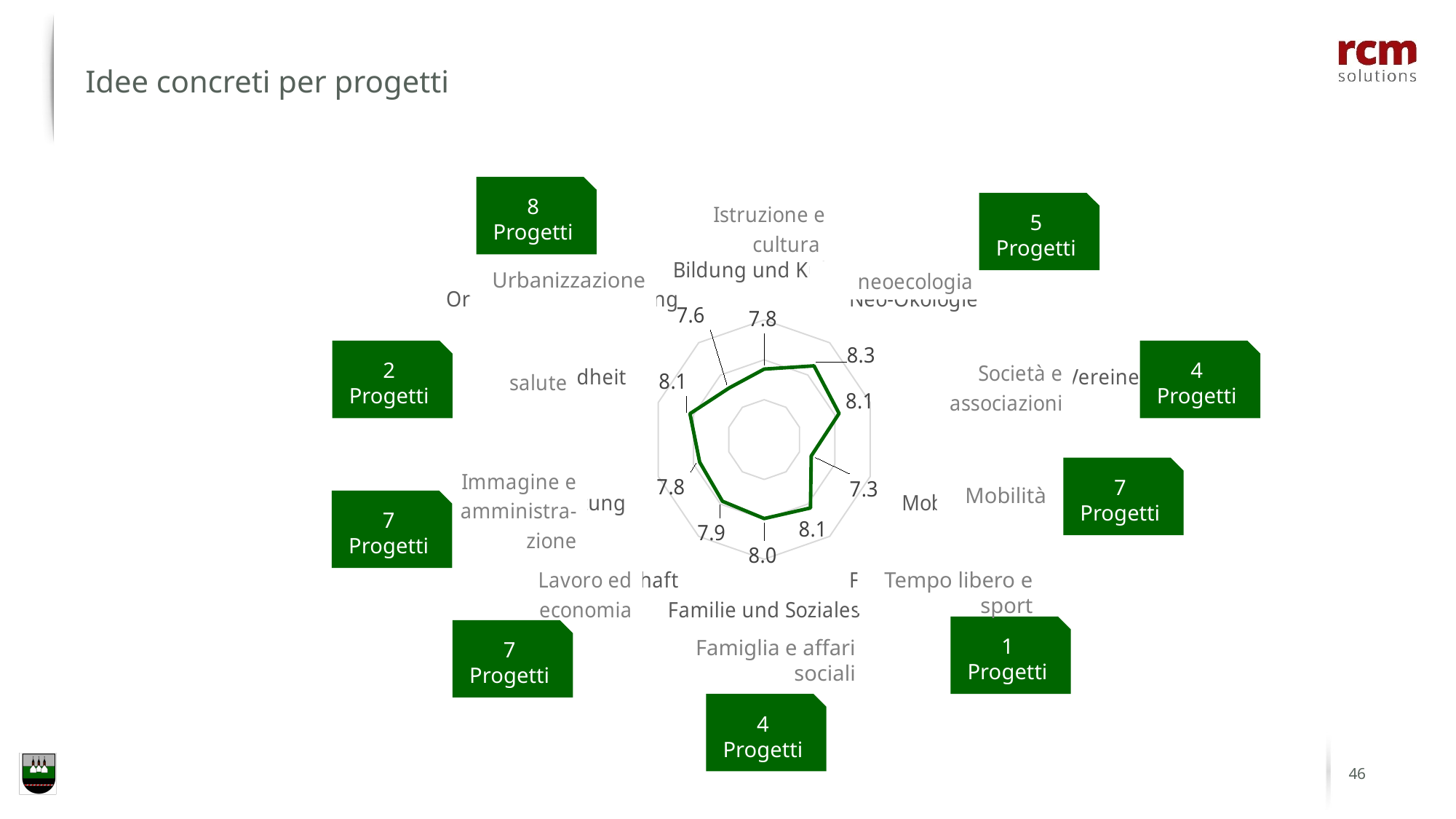
Which has a larger value, Lavoro ed economia or Urbanizzazione? Lavoro ed economia How many categories (axes) does the radar chart have? 10 What is the value for Urbanizzazione on the radar chart? 7.6 Which category has the lowest value on the radar chart? Mobilità What is the value for Istruzione e cultura on the radar chart? 7.8 What colour is the data line on the radar chart? Green What is the value for Famiglia e affari sociali on the radar chart? 8.0 What is the value for neoecologia on the radar chart? 8.3 What is the value for Mobilità on the radar chart? 7.3 What kind of chart is shown on the slide? Radar chart What is the difference between the values for neoecologia and Mobilità? 1.0 Which category has the highest value on the radar chart? neoecologia